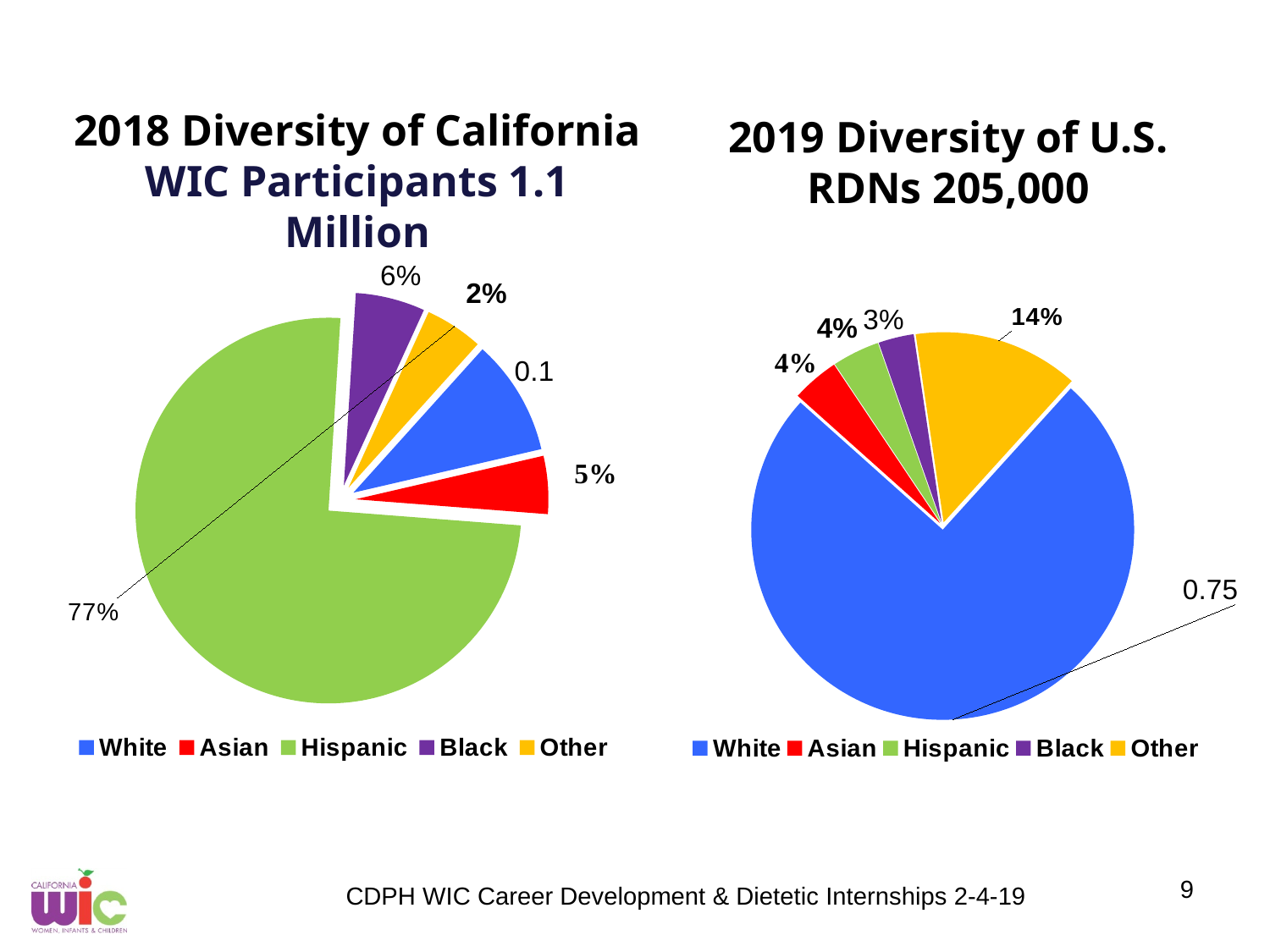
How many categories does the legend of the 2019 Diversity of U.S. RDNs chart list? 5 In the 2019 Diversity of U.S. RDNs chart, which category has the largest slice? White In the 2018 Diversity of California WIC Participants chart, what share is labelled for the Hispanic slice? 77% In the 2018 Diversity of California WIC Participants chart, what is the difference between the Black and Asian shares? 1% In the 2019 Diversity of U.S. RDNs chart, what share is labelled for the Other slice? 14% In the 2019 Diversity of U.S. RDNs chart, what value is labelled for the White slice? 0.75 In the 2018 Diversity of California WIC Participants chart, what share is labelled for the Black slice? 6% What type of chart is the 2018 Diversity of California WIC Participants chart? Pie chart In the 2018 Diversity of California WIC Participants chart, what value is labelled for the White slice? 0.1 In the 2019 Diversity of U.S. RDNs chart, what share is labelled for the Black slice? 3% In the 2018 Diversity of California WIC Participants chart, which category has the largest slice? Hispanic